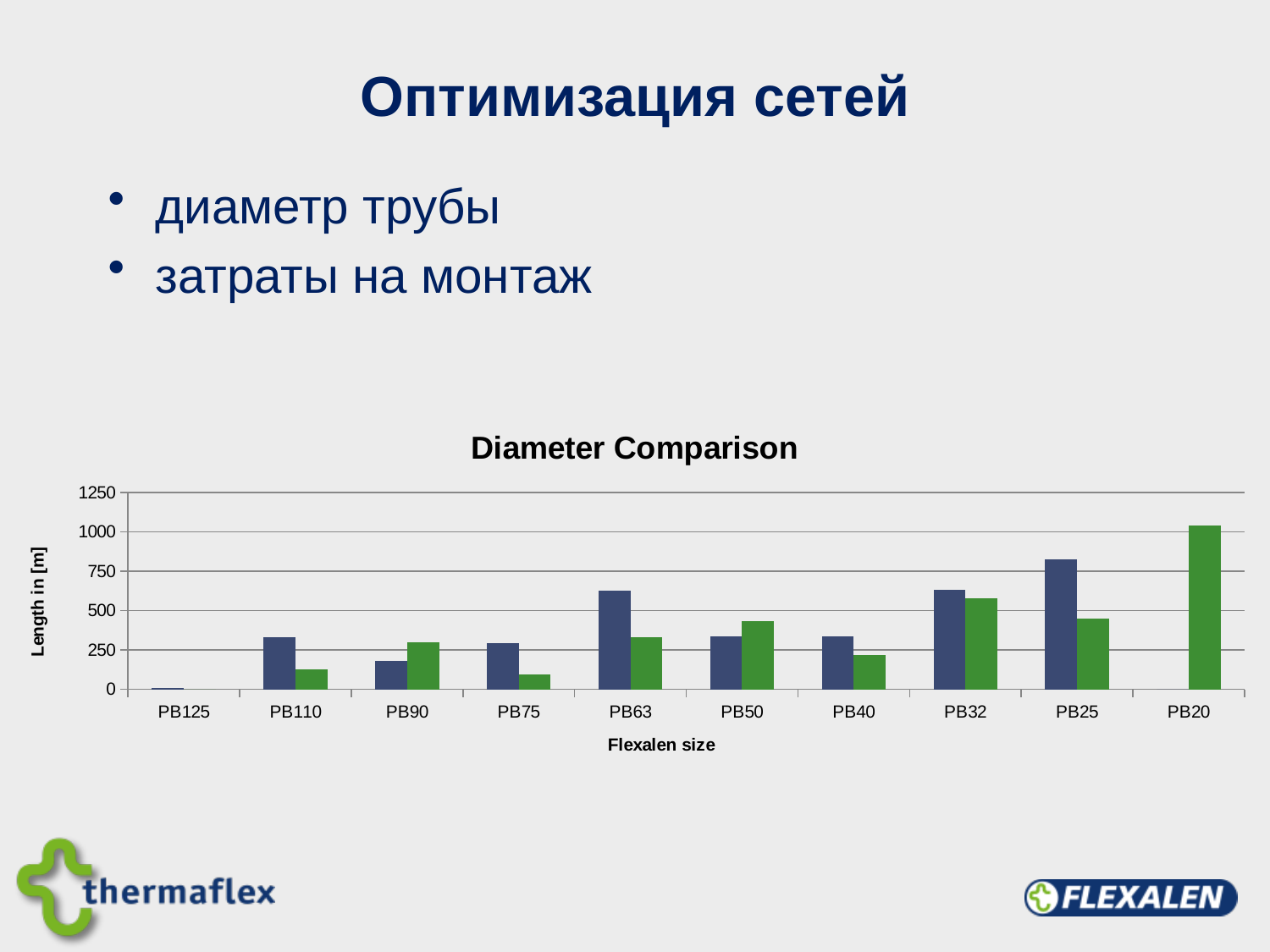
In the Diameter Comparison chart, is the green bar for PB75 greater or less than 250? less What is the y-axis title of the Diameter Comparison chart? Length in [m] What is the x-axis title of the Diameter Comparison chart? Flexalen size How many Flexalen size categories are shown on the x axis of the Diameter Comparison chart? 10 In the Diameter Comparison chart, which Flexalen size has the tallest blue bar? PB25 In the Diameter Comparison chart, is the blue bar for PB25 greater or less than 750? greater In the Diameter Comparison chart, for PB90, which bar is taller, the blue one or the green one? green What kind of chart is the Diameter Comparison chart? bar chart In the Diameter Comparison chart, is the blue bar for PB63 greater or less than 500? greater In the Diameter Comparison chart, for PB25, which bar is taller, the blue one or the green one? blue In the Diameter Comparison chart, which Flexalen size has the tallest green bar? PB20